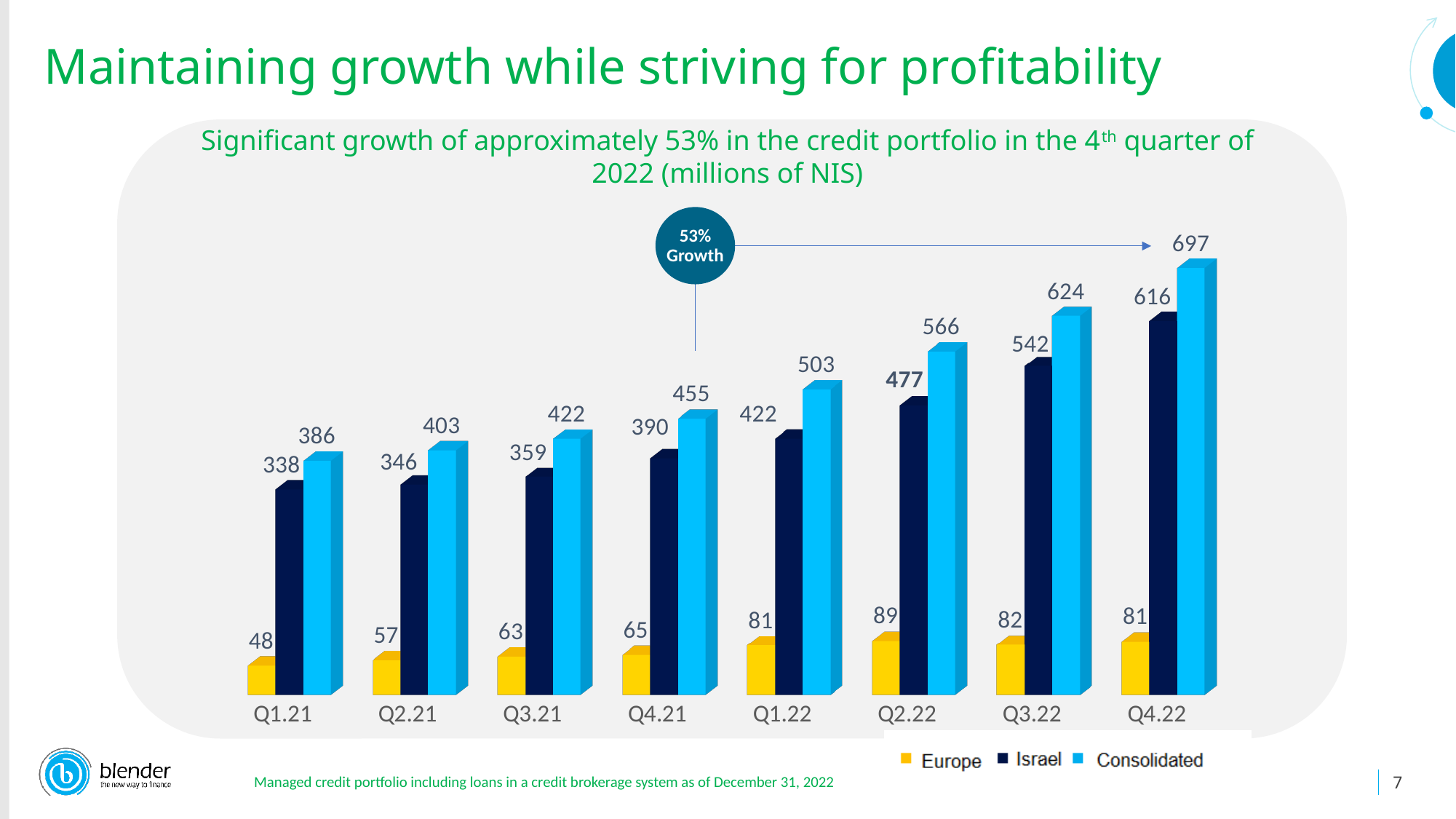
Which quarter has the lowest Europe value? Q1.21 Which quarter has the highest Consolidated value? Q4.22 What is the Israel value for Q2.22? 477 What is the Europe value for Q1.21? 48 What is the Consolidated value for Q4.22? 697 Do the Consolidated values rise or fall from Q1.21 to Q4.22? Rise How many series does the legend list? 3 What is the difference between the Consolidated values for Q4.22 and Q4.21? 242 Which is larger, the Israel value for Q3.22 or the Consolidated value for Q1.22? Israel value for Q3.22 What kind of chart is shown on the slide? Bar chart How many quarters are shown on the x axis? 8 Which series is shown in yellow in the legend? Europe